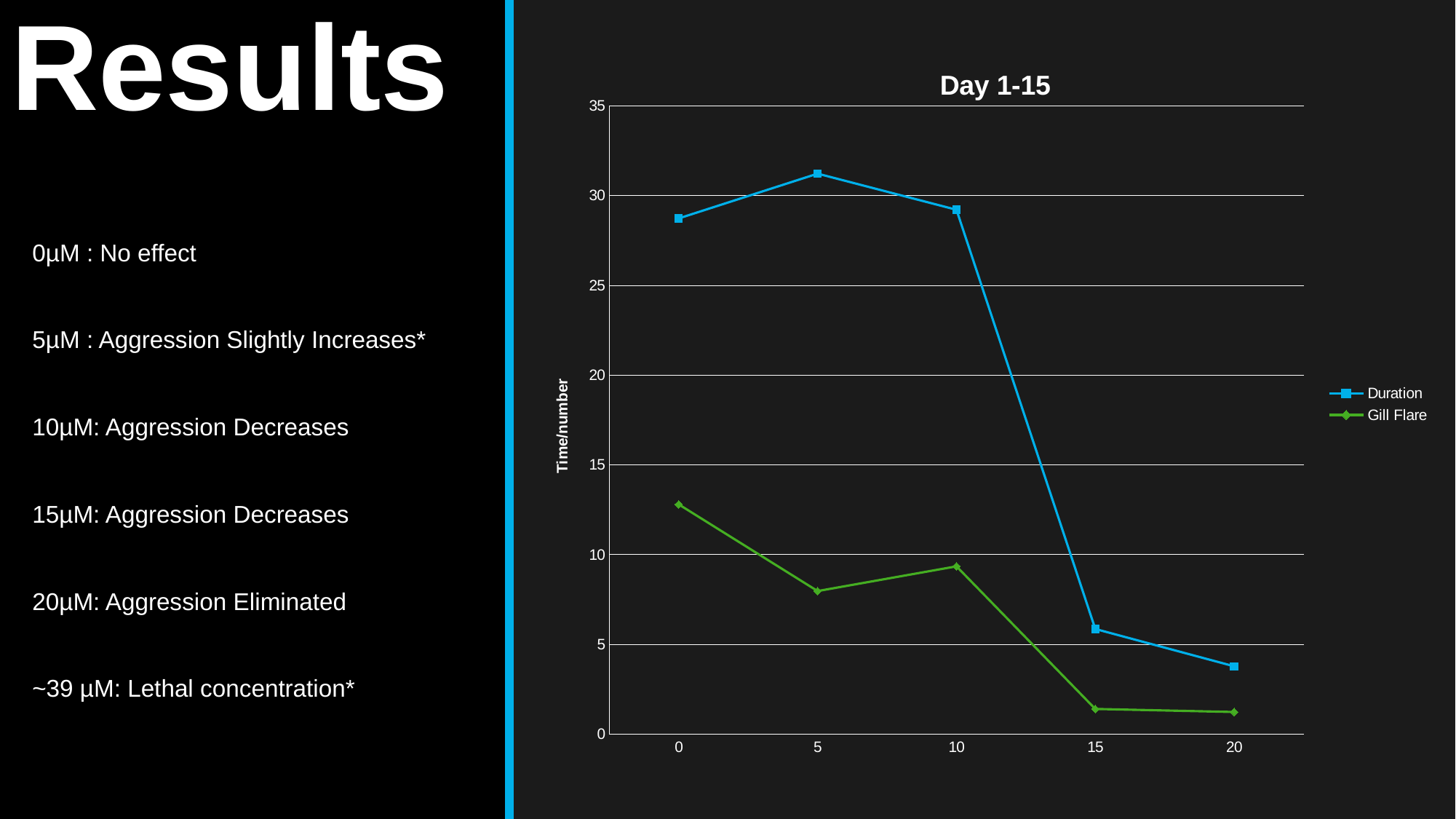
At which x-axis value does the Gill Flare series reach its highest point? 0 At x = 10, which series has the larger value, Duration or Gill Flare? Duration How many points are plotted along the x axis for each series? 5 At which x-axis value does the Duration series reach its lowest point? 20 Is the Gill Flare value at x = 0 greater or less than 10? greater What is the title of the chart? Day 1-15 Does the Duration series rise or fall between x = 10 and x = 15? fall Is the Duration value at x = 5 greater or less than 30? greater At which x-axis value does the Duration series reach its highest point? 5 Is the Duration value at x = 15 greater or less than 10? less How many series does the legend list? 2 What kind of chart is shown on the slide? line chart